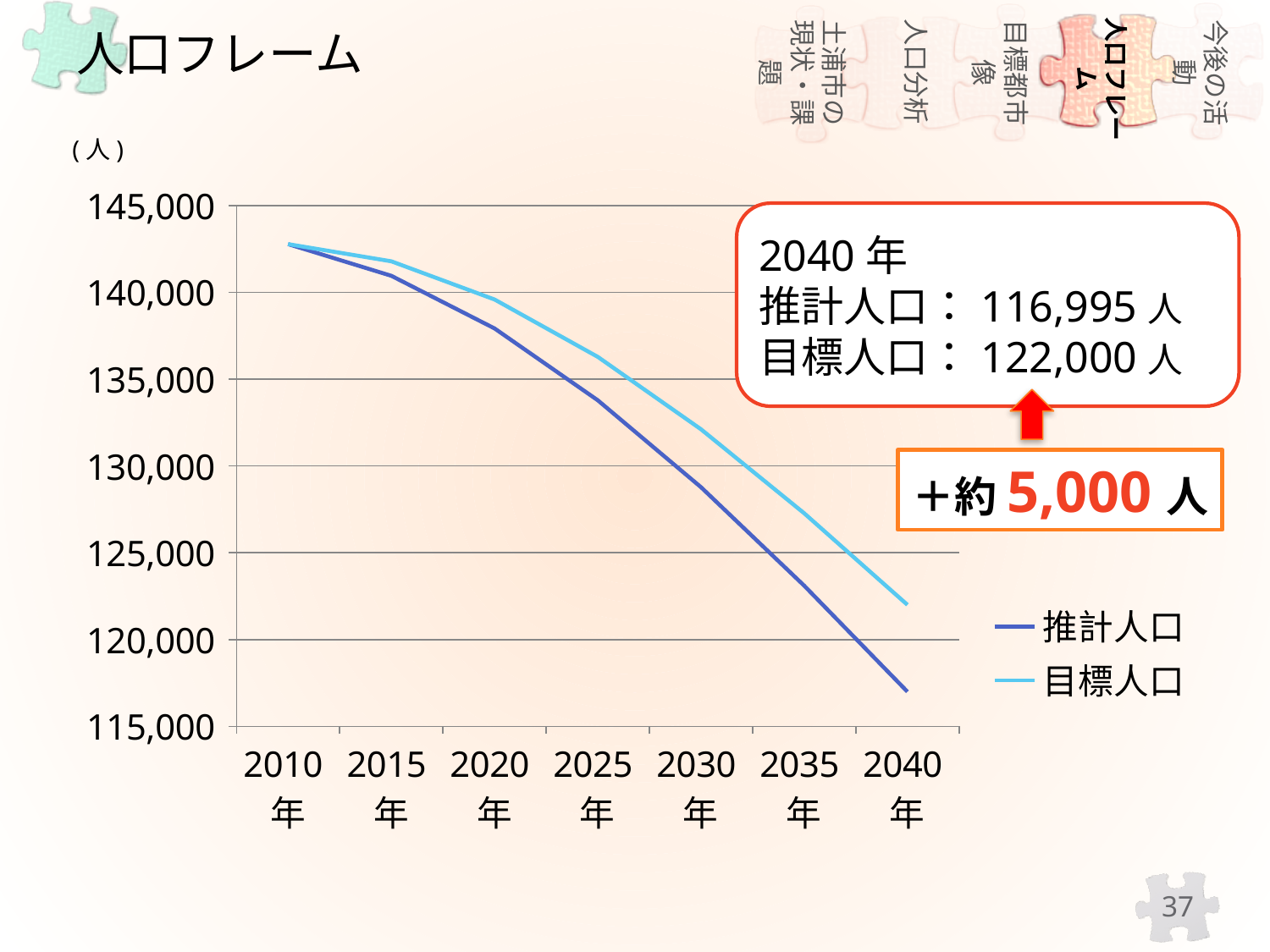
In 2040, which is larger, 推計人口 or 目標人口? 目標人口 Is the 目標人口 value for 2020 greater or less than 135,000? greater What unit is shown above the y axis of the chart? 人 In which year is 推計人口 at its highest? 2010年 What is the difference between 目標人口 and 推計人口 in 2040? 5,005人 Is the 推計人口 value for 2035 greater or less than 125,000? less How many series does the chart legend list? 2 Do the values of 推計人口 rise or fall from 2010 to 2040? fall What kind of chart is shown on the slide? line chart What is the 推計人口 value for 2040 according to the callout on the chart? 116,995人 How many years are marked along the x axis of the chart? 7 What is the 目標人口 value for 2040 according to the callout on the chart? 122,000人